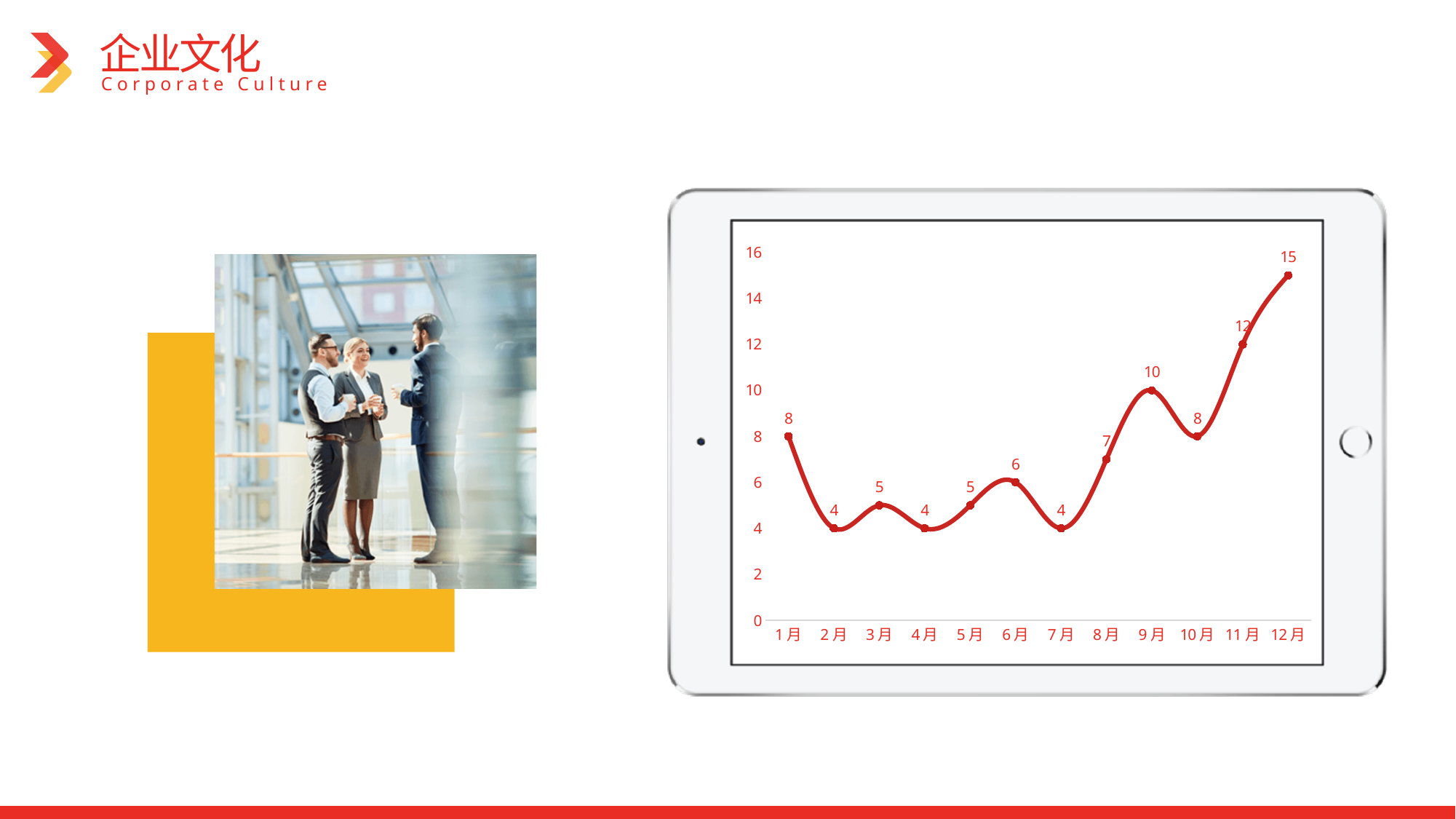
What is the highest value plotted on the chart? 15 Do the values rise or fall from 9月 to 10月? fall How many months are plotted on the x axis? 12 What is the lowest value plotted on the chart? 4 Which is larger, the value for 6月 or the value for 8月? 8月 What is the difference between the values for 1月 and 2月? 4 What is the difference between the values for 12月 and 11月? 3 What is the value for 9月? 10 Which month has the highest value? 12月 What is the value for 11月? 12 What kind of chart is shown on the slide? line chart What is the value for 1月? 8